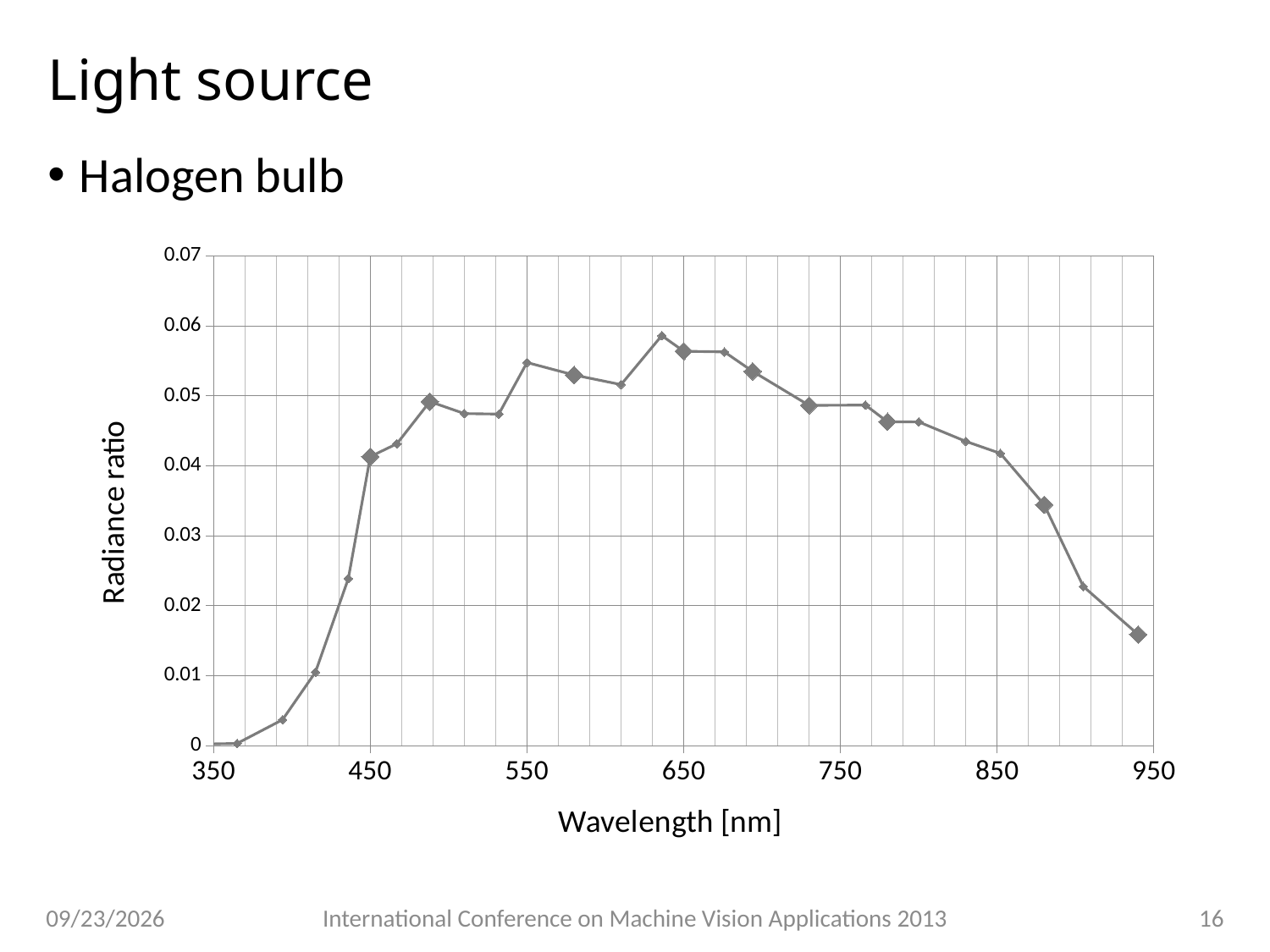
What is the label of the x axis of the chart? Wavelength [nm] Does the radiance ratio rise or fall as the wavelength increases from 350 nm to 550 nm? rise Is the radiance ratio at 550 nm greater or less than 0.05? greater Is the radiance ratio at 650 nm greater or less than 0.05? greater Is the radiance ratio at 750 nm greater or less than 0.04? greater Which is larger, the radiance ratio at 550 nm or at 450 nm? 550 nm What kind of chart is shown on the slide? line chart Does the radiance ratio rise or fall as the wavelength increases from 750 nm to 950 nm? fall What is the label of the y axis of the chart? Radiance ratio